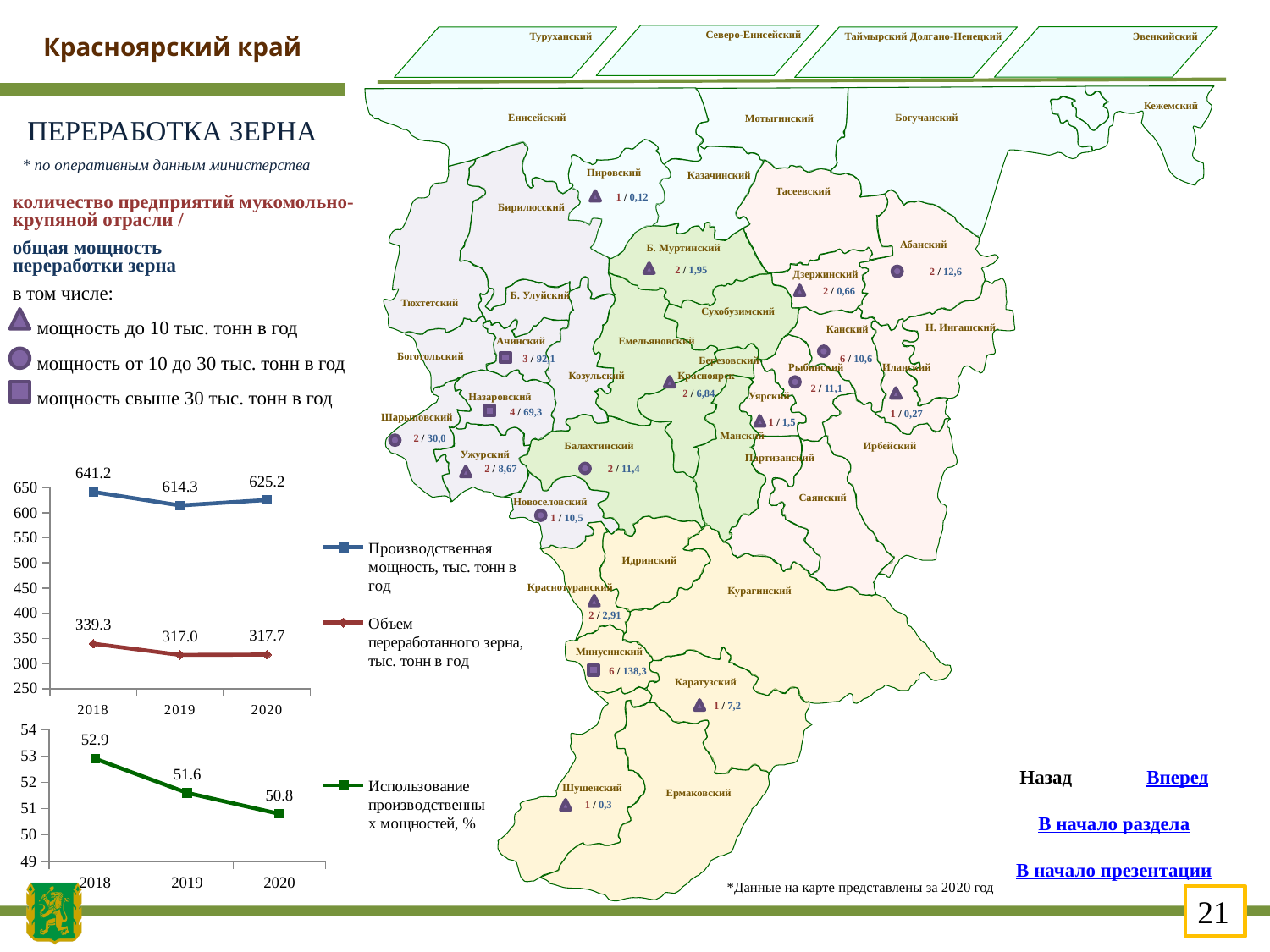
In the upper line chart, which is larger: Объем переработанного зерна in 2020 or in 2019? 2020 What type of chart is the lower chart on the slide? line chart In the lower line chart, what is the difference between the 2018 and 2020 values? 2.1 How many years (data points) are plotted in the lower line chart? 3 In the upper line chart, which year has the highest value for Производственная мощность? 2018 In the upper line chart, what is the difference between Производственная мощность in 2018 and 2019? 26.9 How many series does the legend of the upper line chart list? 2 In the upper line chart, what is the value of Производственная мощность, тыс. тонн в год for 2019? 614.3 In the upper line chart, which year has the lowest value for Объем переработанного зерна? 2019 In the lower line chart, what is the value of Использование производственных мощностей, % for 2020? 50.8 In the lower line chart, do the values rise or fall from 2018 to 2020? fall In the upper line chart, what is the value of Объем переработанного зерна, тыс. тонн в год for 2018? 339.3